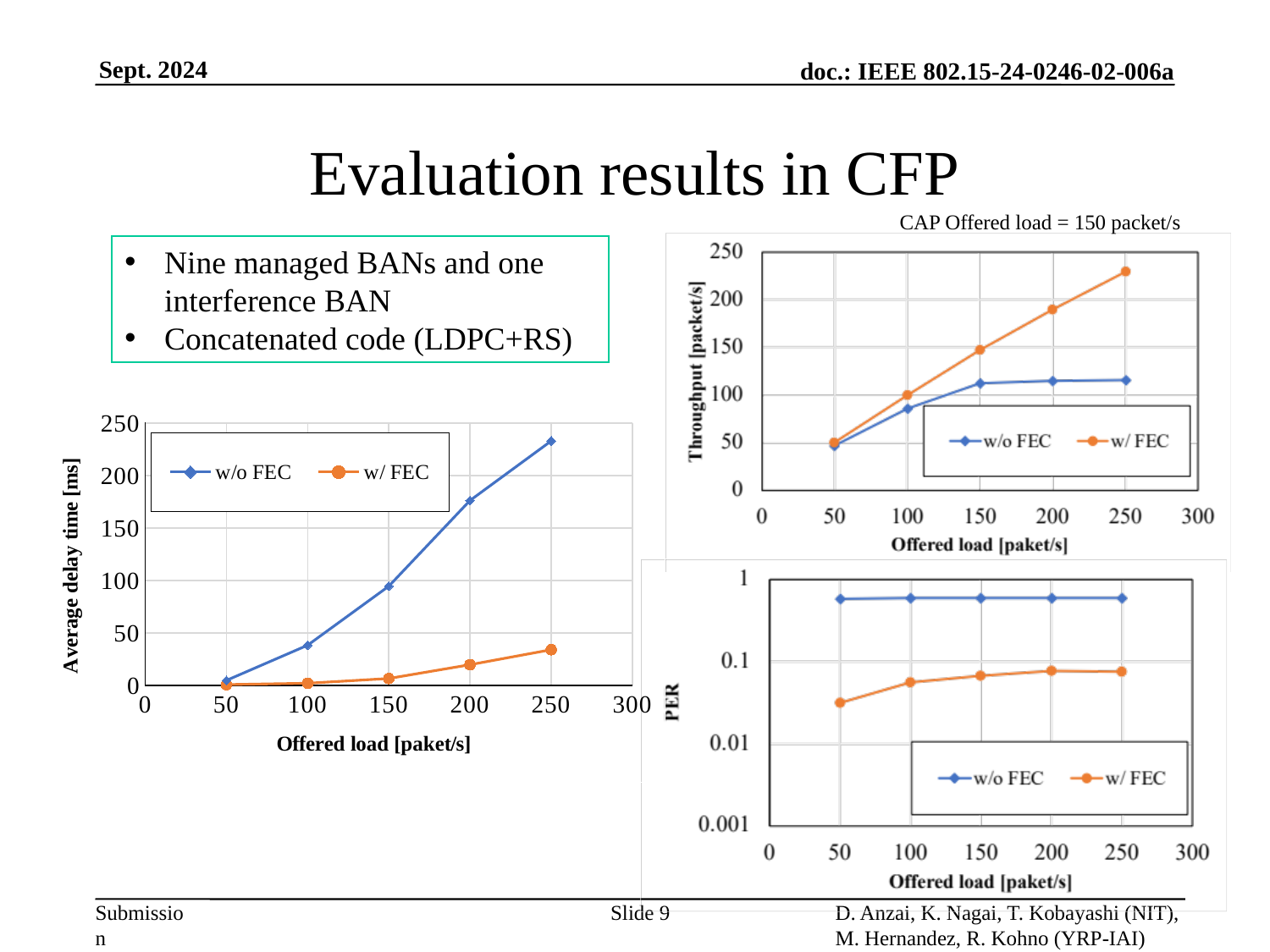
In the PER chart, is the w/ FEC value at an offered load of 50 greater or less than 0.1? less In the Average delay time chart, how many data points are plotted for the w/o FEC series? 5 In the PER chart, at an offered load of 150, which series has the higher PER, w/o FEC or w/ FEC? w/o FEC In the Throughput chart, is the w/ FEC value at an offered load of 250 greater or less than 200? greater In the Throughput chart, at an offered load of 250, which series has the higher throughput, w/o FEC or w/ FEC? w/ FEC In the Average delay time chart, how many series does the legend list? 2 In the Average delay time chart, is the w/o FEC value at an offered load of 250 greater or less than 200? greater What is the y-axis label of the chart on the left of the slide? Average delay time [ms] In the Average delay time chart, at an offered load of 200, which series has the larger delay, w/o FEC or w/ FEC? w/o FEC In the Average delay time chart, does the w/o FEC delay rise or fall as the offered load increases? rises What kind of chart is the Average delay time chart on the left of the slide? line chart